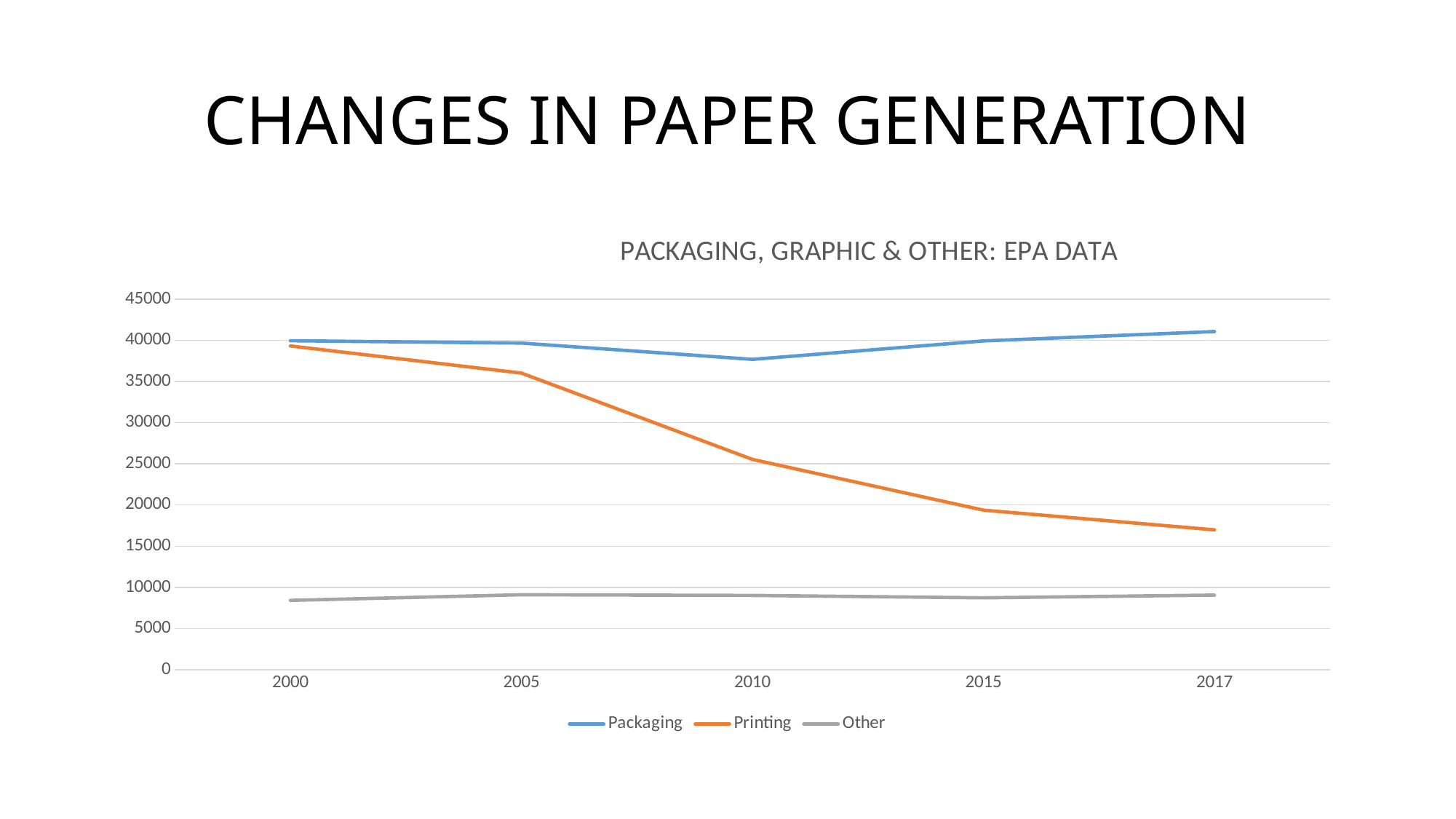
Is the value for Printing in 2010 greater or less than 30000? less Which series has the lowest values across all years? Other Which series has the highest value in 2017? Packaging Which series is shown in orange in the legend? Printing What kind of chart is shown on the slide? line chart In 2015, which is larger: the value for Packaging or the value for Printing? Packaging Is the value for Other in 2000 greater or less than 10000? less How many series does the legend list? 3 Does the Printing series rise or fall from 2000 to 2017? fall Is the value for Packaging in 2017 greater or less than 40000? greater What is the title of the chart? PACKAGING, GRAPHIC & OTHER: EPA DATA How many years are shown on the x axis? 5